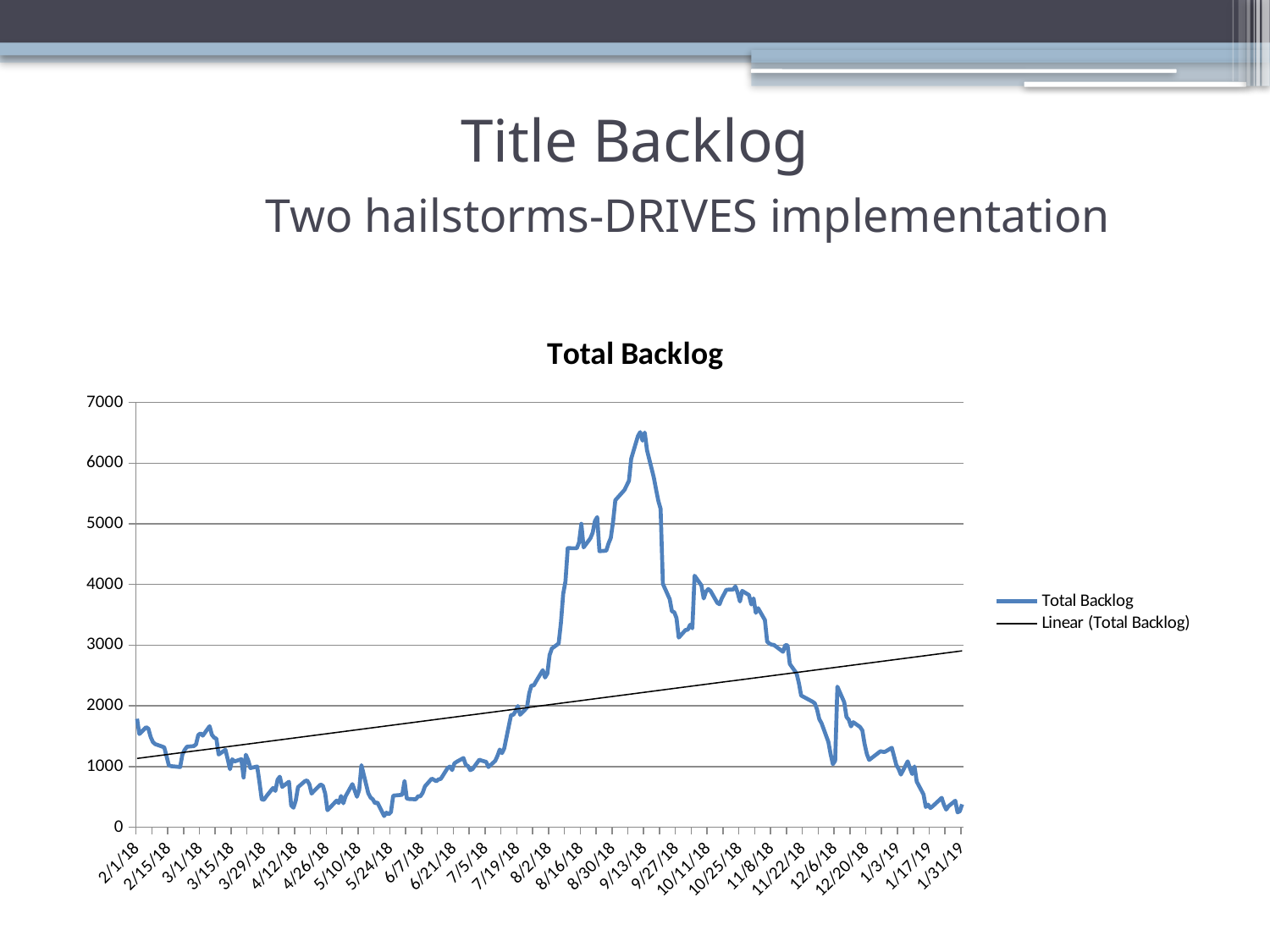
What kind of chart is shown on the slide? Line chart What are the two entries in the chart legend? Total Backlog and Linear (Total Backlog) Is the Total Backlog value at 5/24/18 greater or less than 1000? less Is the Total Backlog value at 10/25/18 greater or less than 3000? greater Which is larger, the Total Backlog value at 2/1/18 or at 1/31/19? 2/1/18 Does the linear trendline rise or fall from left to right across the chart? Rises Is the Total Backlog value at 8/16/18 greater or less than 4000? greater What is the title of the chart? Total Backlog In which month does the Total Backlog line reach its highest point? September 2018 How many series does the legend list? 2